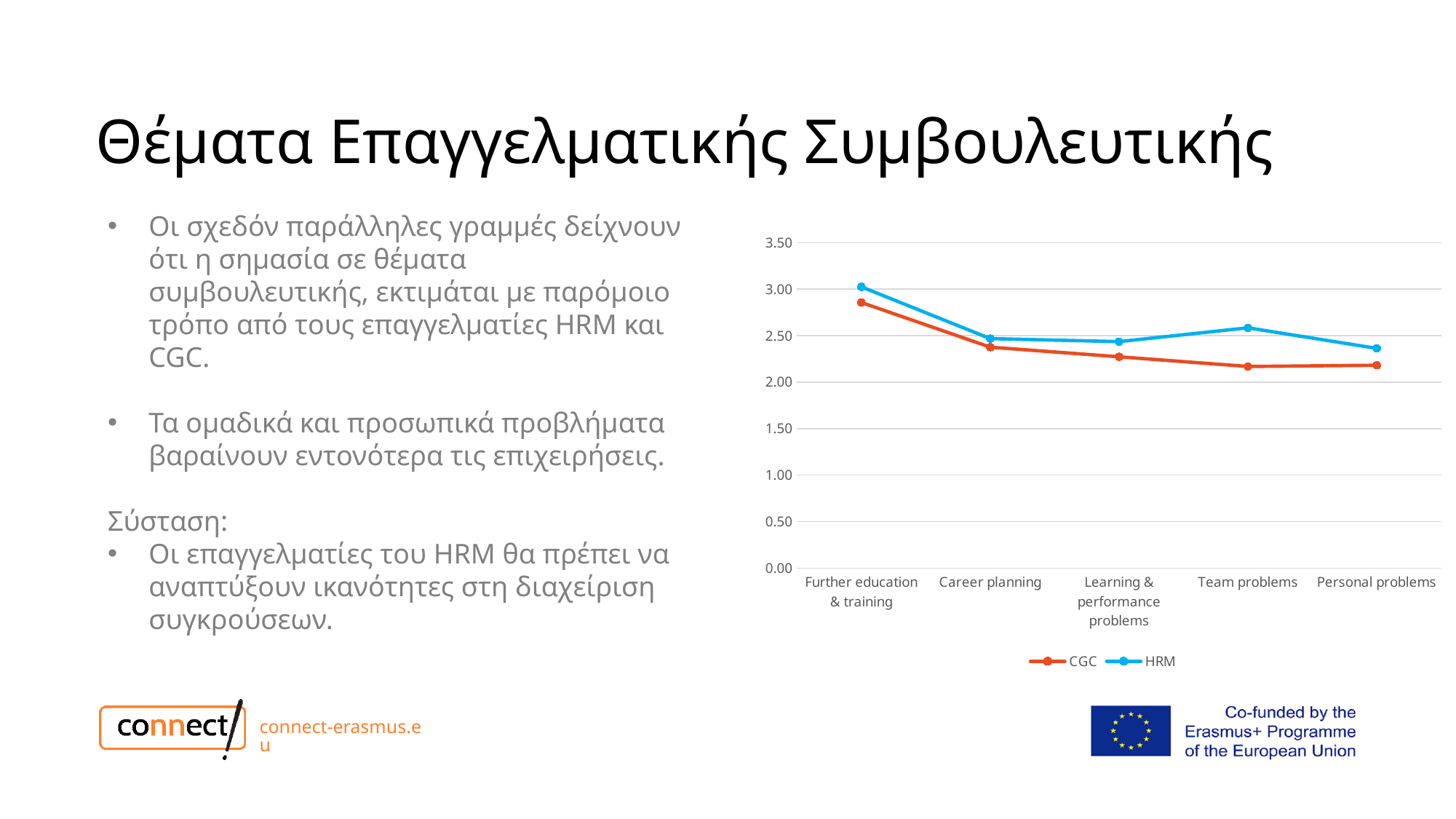
Is the HRM value for Personal problems greater or less than 2.00? greater How many series does the chart legend list? 2 How many categories are shown on the x axis of the chart? 5 Which series has the larger value for Team problems, CGC or HRM? HRM Is the CGC value for Further education & training greater or less than 2.50? greater Is the CGC value for Team problems greater or less than 2.50? less For which category is the HRM value highest? Further education & training For which category is the CGC value highest? Further education & training Which colour is used for the HRM series in the chart? blue Which series has the larger value for Further education & training, CGC or HRM? HRM What kind of chart is shown on the slide? line chart Does the CGC line generally rise or fall from Further education & training to Personal problems? fall